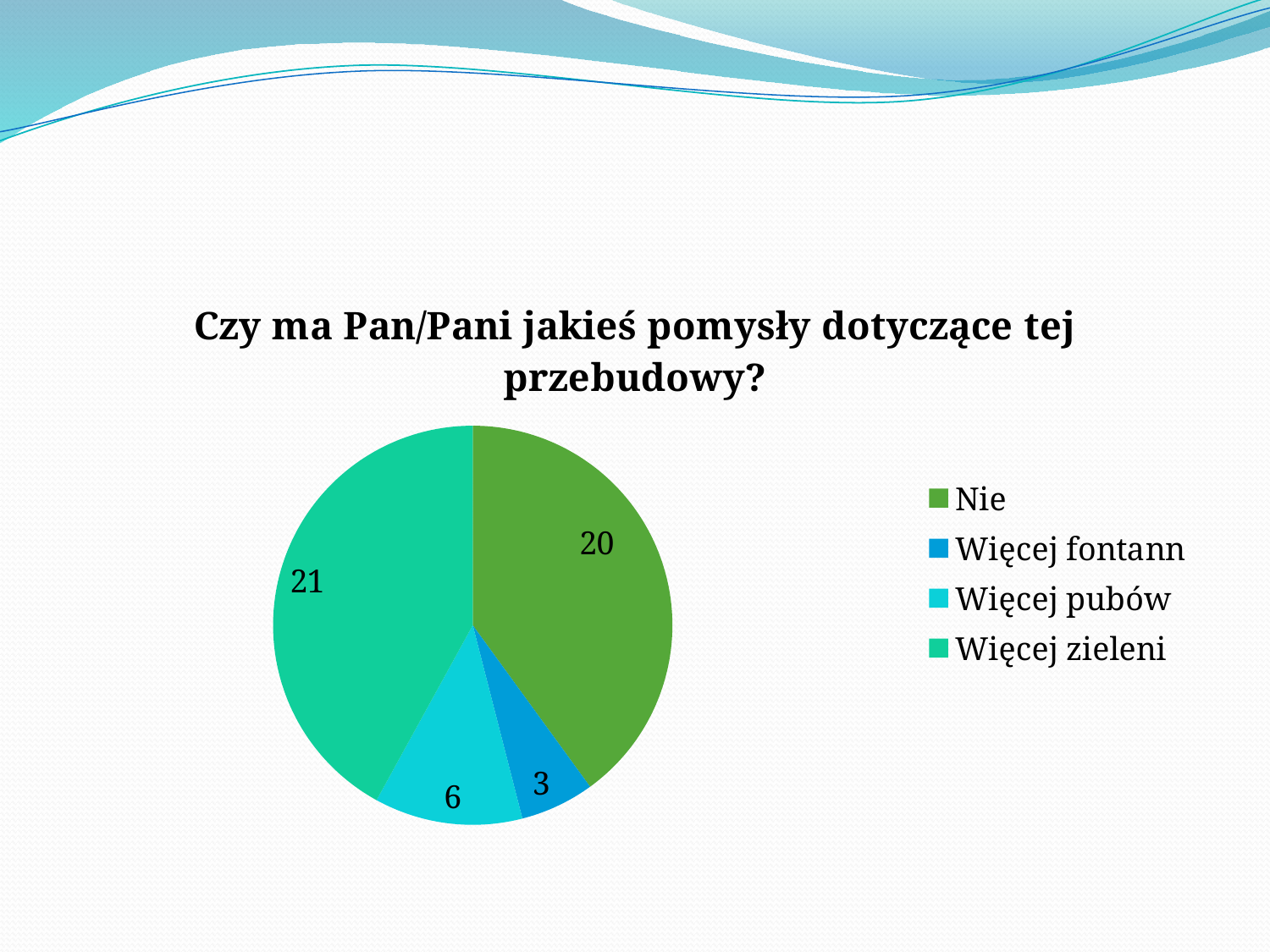
What is the difference between the values for "Więcej pubów" and "Więcej fontann"? 3 What is the value for "Więcej zieleni"? 21 What is the value for "Nie"? 20 What share of the pie does "Nie" represent? 40% What type of chart is shown on the slide? pie chart Which category has the smallest slice? Więcej fontann What is the value for "Więcej pubów"? 6 What is the title of the chart? Czy ma Pan/Pani jakieś pomysły dotyczące tej przebudowy? What is the value for "Więcej fontann"? 3 How many categories does the pie chart have? 4 Which is larger, the value for "Nie" or the value for "Więcej pubów"? Nie Which category has the largest slice? Więcej zieleni